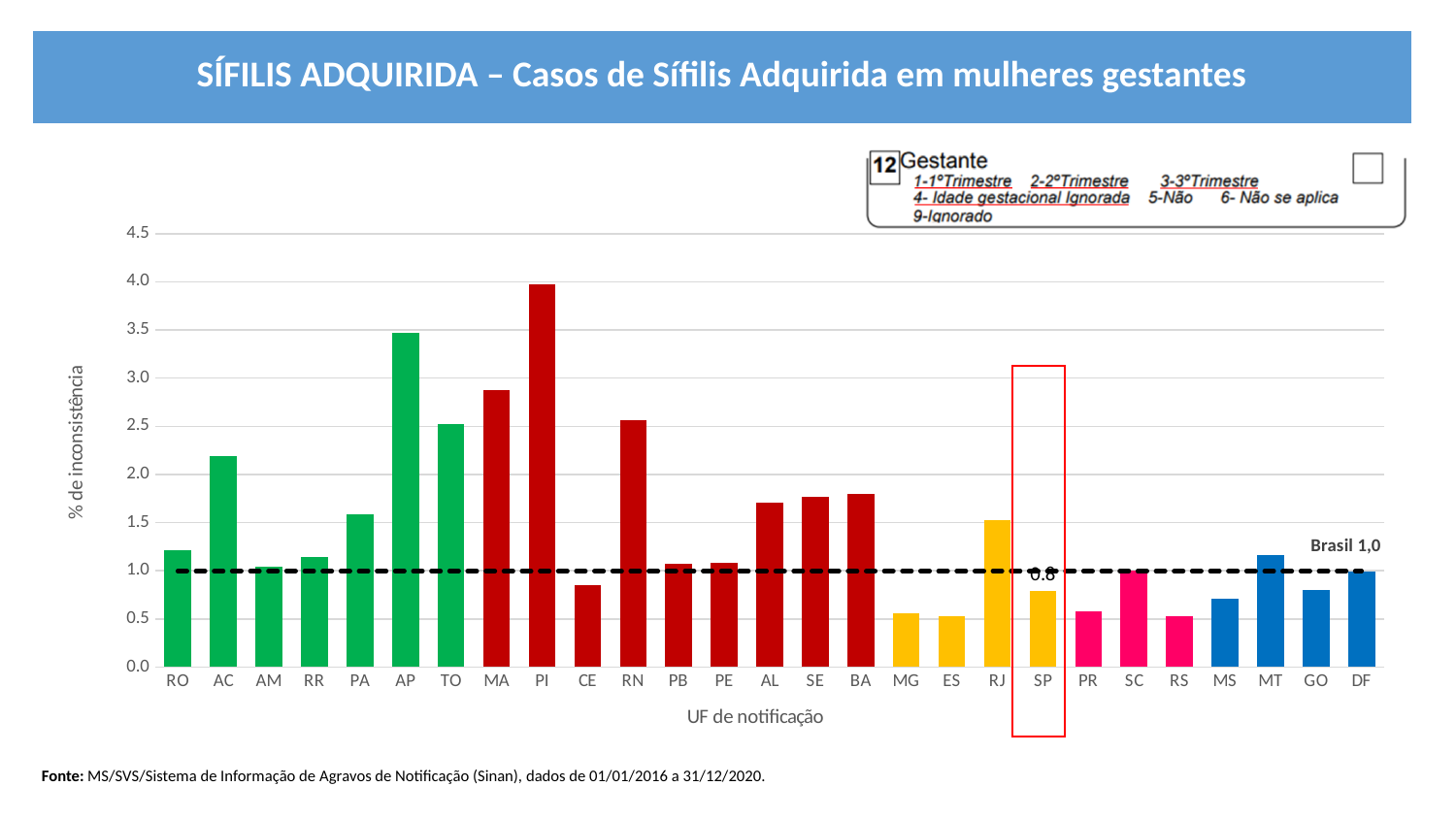
Is the value for PI greater or less than 3.5? greater How many UFs are shown on the x axis? 27 Is the value for AP greater or less than 3.0? greater What is the title of the x axis? UF de notificação What is the value of % de inconsistência for SP? 0.8 Is the value for MT greater or less than 1.0? greater What type of chart is shown on the slide? bar chart What value does the dashed reference line labelled Brasil represent? 1,0 Which has a higher % de inconsistência, MA or RN? MA Which has a higher % de inconsistência, AC or PA? AC Which UF has the highest % de inconsistência? PI